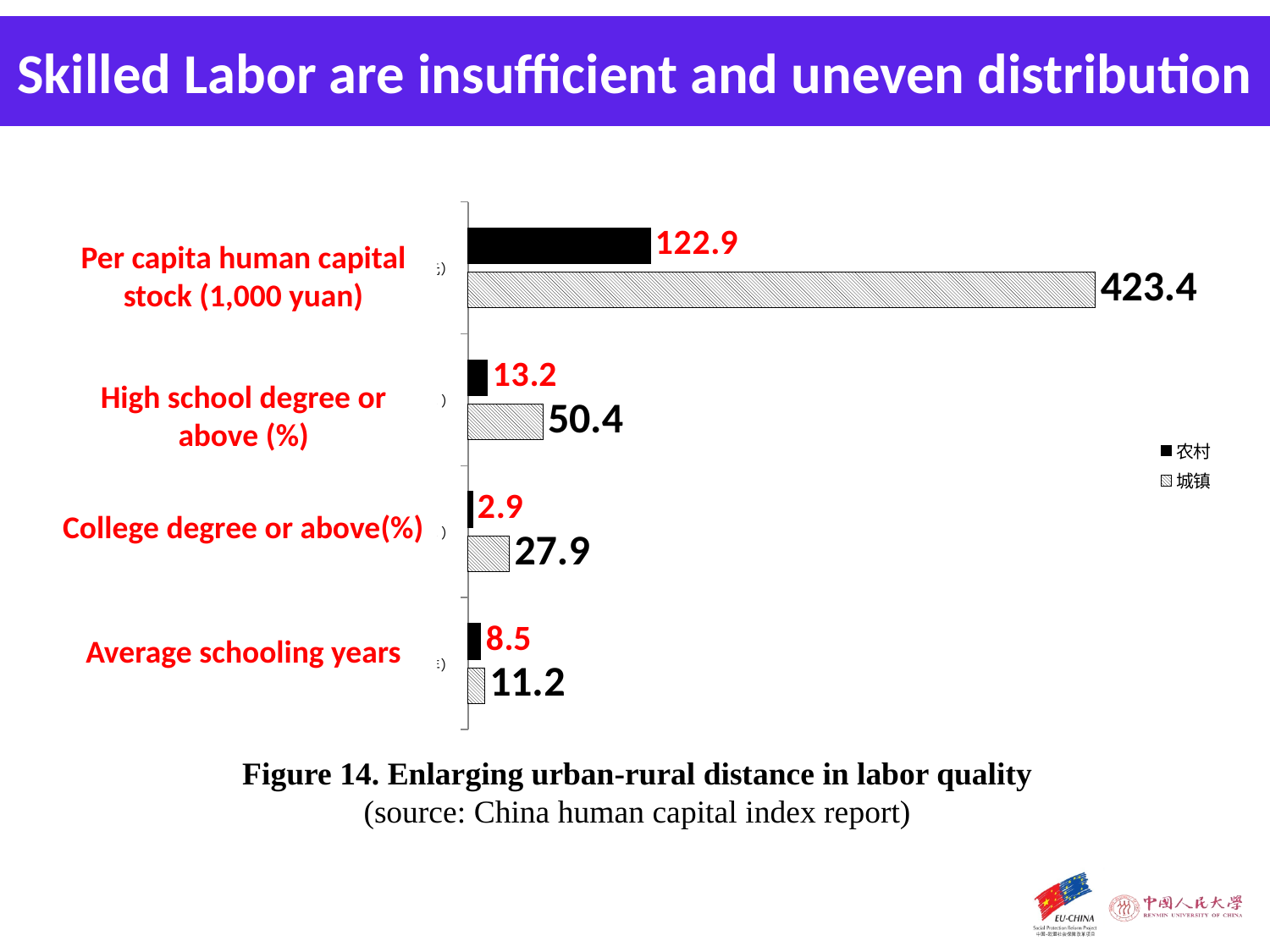
Which category has the lowest 农村 (rural, black bar) value? College degree or above(%) For Average schooling years, which series has the larger value, 农村 (rural) or 城镇 (urban)? 城镇 (urban) What is the 城镇 (urban, hatched bar) value for College degree or above(%)? 27.9 What is the 城镇 (urban, hatched bar) value for Per capita human capital stock (1,000 yuan)? 423.4 How many series does the chart legend list? 2 How many categories are shown on the chart? 4 What is the 农村 (rural, black bar) value for Average schooling years? 8.5 What is the difference between the 城镇 (urban) and 农村 (rural) values for Per capita human capital stock (1,000 yuan)? 300.5 What is the difference between the 城镇 (urban) and 农村 (rural) values for High school degree or above (%)? 37.2 What is the 农村 (rural, black bar) value for High school degree or above (%)? 13.2 What type of chart is shown on the slide? bar chart What is the figure caption below the chart? Figure 14. Enlarging urban-rural distance in labor quality